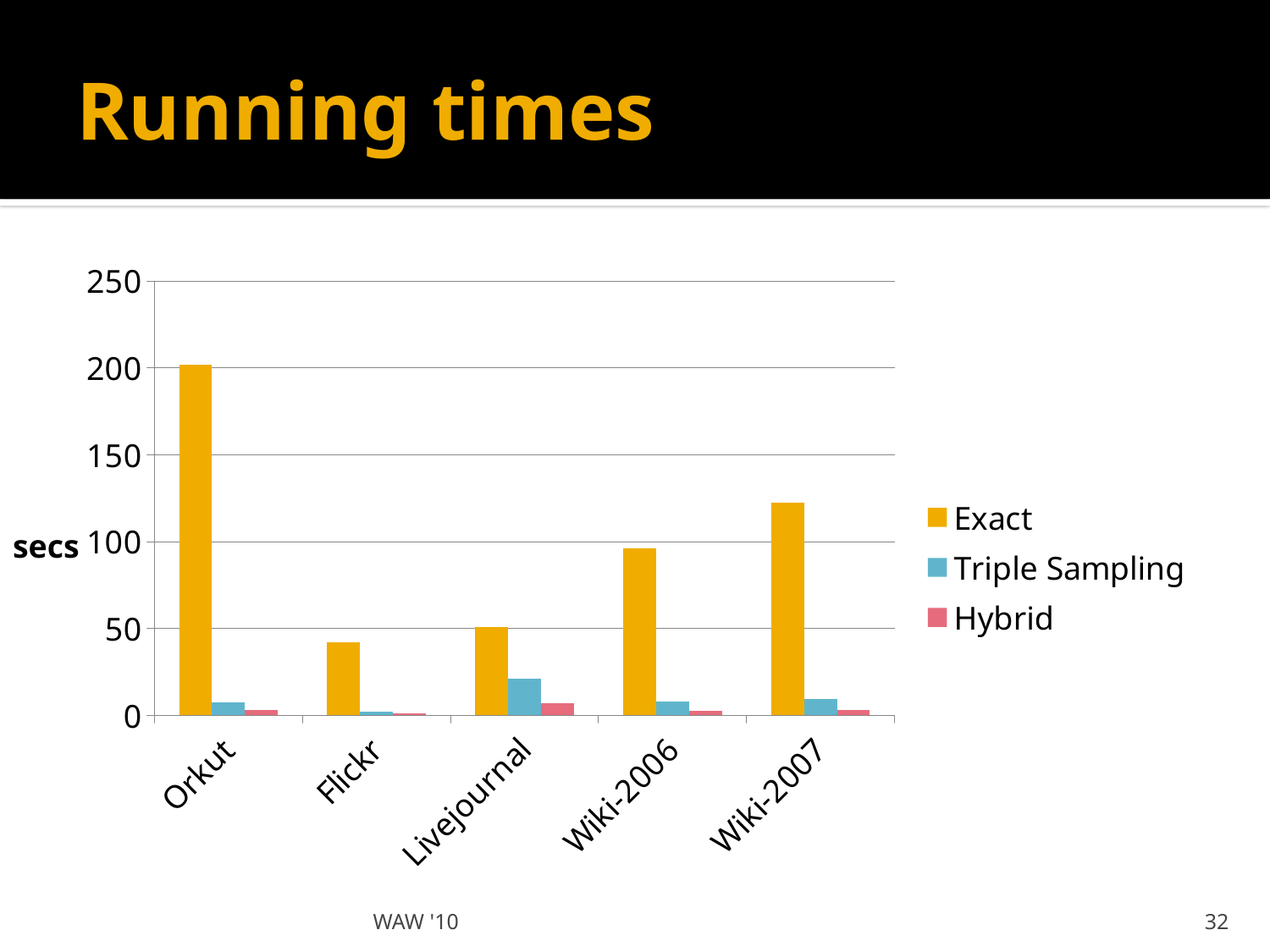
Is the Exact value for Flickr greater or less than 50? less Is the Exact value for Wiki-2007 greater or less than 100? greater Is the Triple Sampling value for Livejournal greater or less than 50? less Which category has the highest Triple Sampling running time? Livejournal Which category has the lowest Exact running time? Flickr Which category has the highest Exact running time? Orkut What is the label on the y axis of the chart? secs How many categories are shown on the x axis? 5 How many series does the legend list? 3 What kind of chart is shown on the slide? bar chart Which is larger, the Exact value for Wiki-2007 or the Exact value for Wiki-2006? Wiki-2007